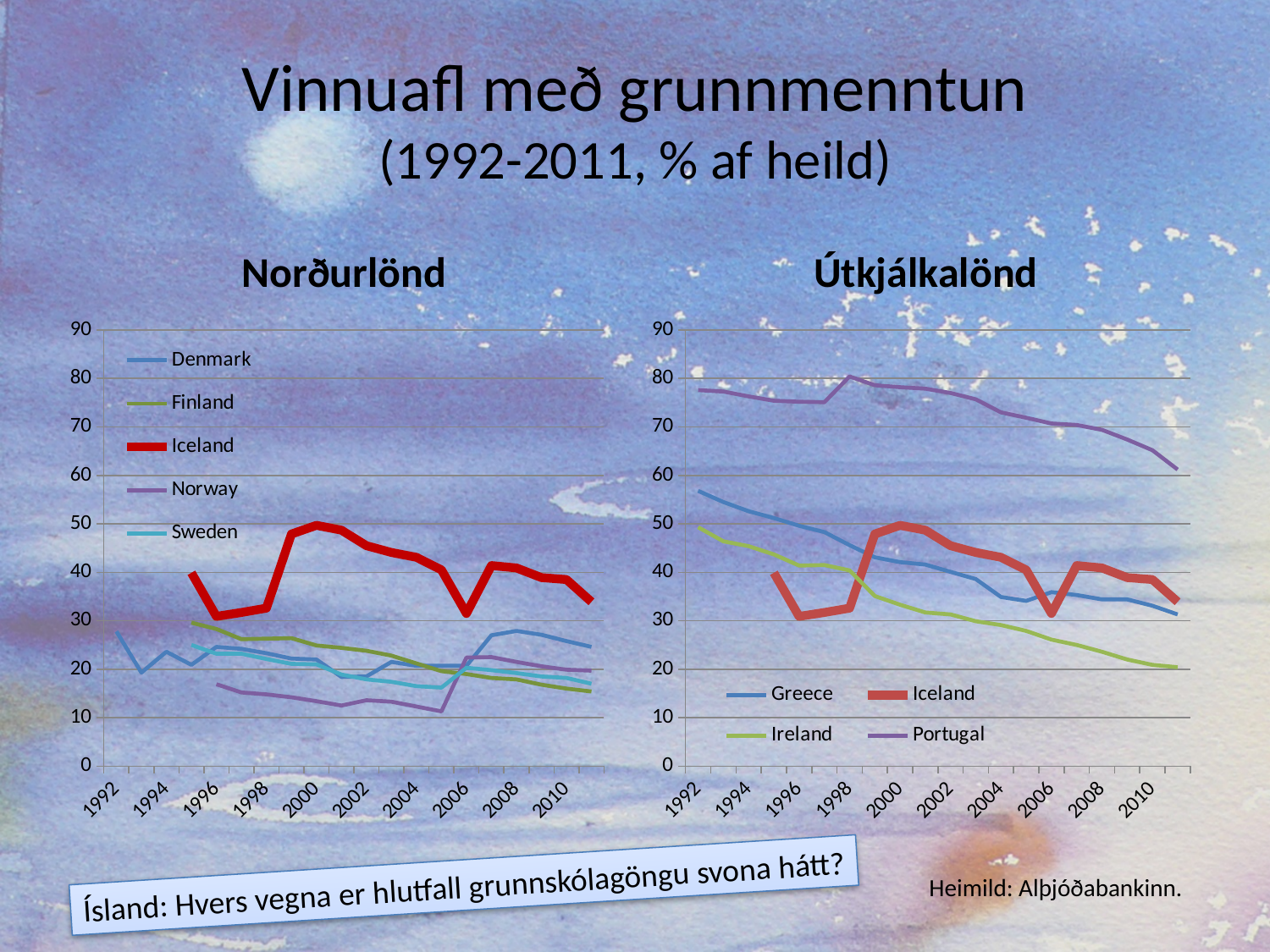
In the Útkjálkalönd chart, does the value for Portugal rise or fall from 1992 to 2011? fall What kind of chart is the Norðurlönd chart? line chart How many series does the legend of the Útkjálkalönd chart list? 4 In the Útkjálkalönd chart, is the value for Portugal in 1992 greater or less than 70? greater In the Norðurlönd chart, is the value for Norway in 2005 greater or less than 20? less What is the title of the right-hand chart? Útkjálkalönd In the Norðurlönd chart, which series is highest in 2000? Iceland In the Útkjálkalönd chart, is the value for Greece in 1992 greater or less than 50? greater In the Norðurlönd chart, which series is lowest in 2005? Norway How many series does the legend of the Norðurlönd chart list? 5 In the Útkjálkalönd chart, which series has the highest values across the whole period? Portugal In the Útkjálkalönd chart, which is larger in 2000, Portugal or Greece? Portugal